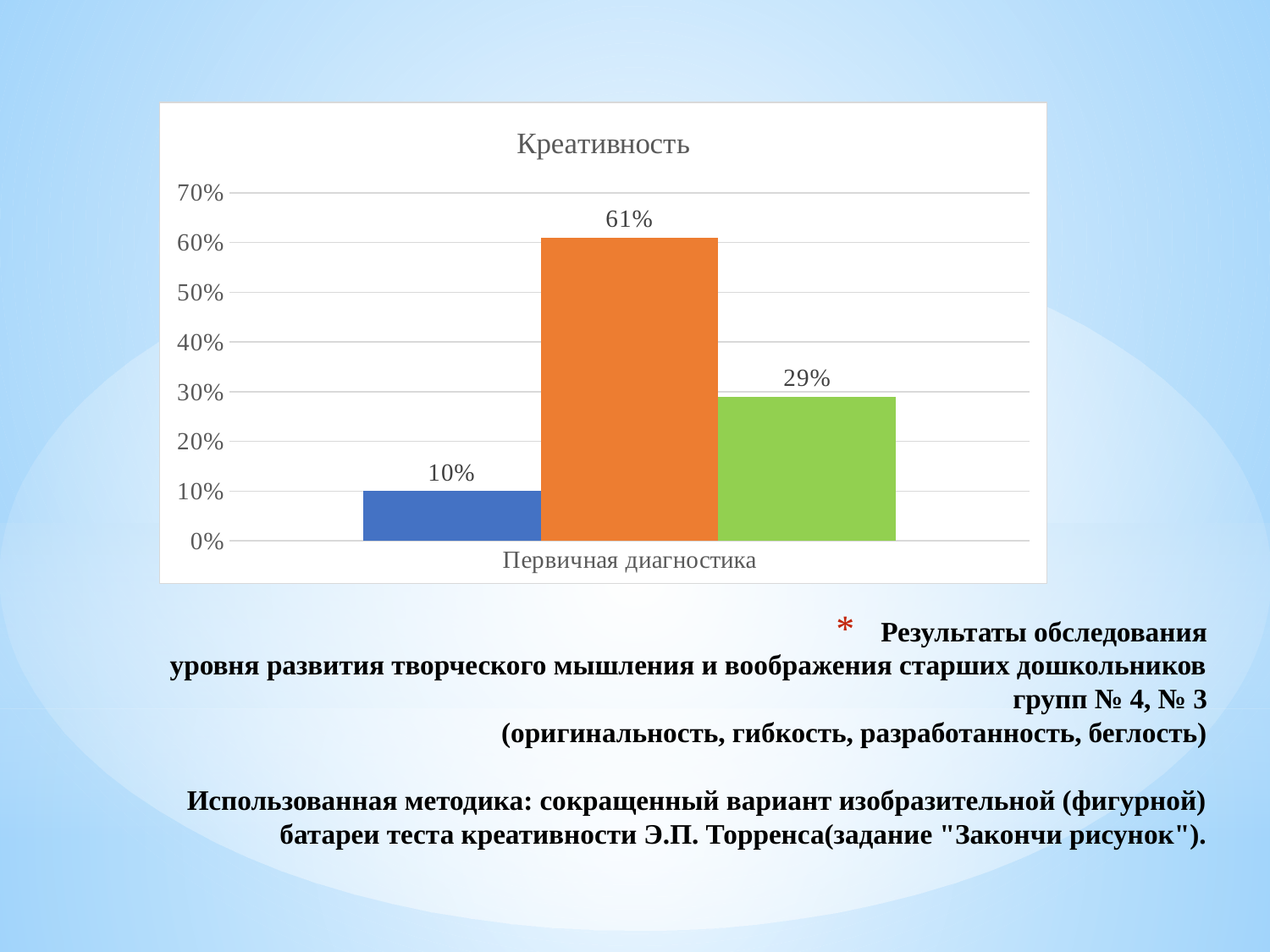
Which bar has the lowest value in the chart? the blue bar (10%) Which is larger, the green bar or the blue bar? the green bar What is the difference between the orange bar and the green bar? 32% What is the difference between the green bar and the blue bar? 19% How many bars are plotted in the chart? 3 What is the value of the green bar in the chart? 29% What is the category label shown on the x axis of the chart? Первичная диагностика What is the value of the blue bar in the chart? 10% What is the title of the chart? Креативность What kind of chart is shown on the slide? bar chart What is the value of the orange bar in the chart? 61% Which bar has the highest value in the chart? the orange bar (61%)